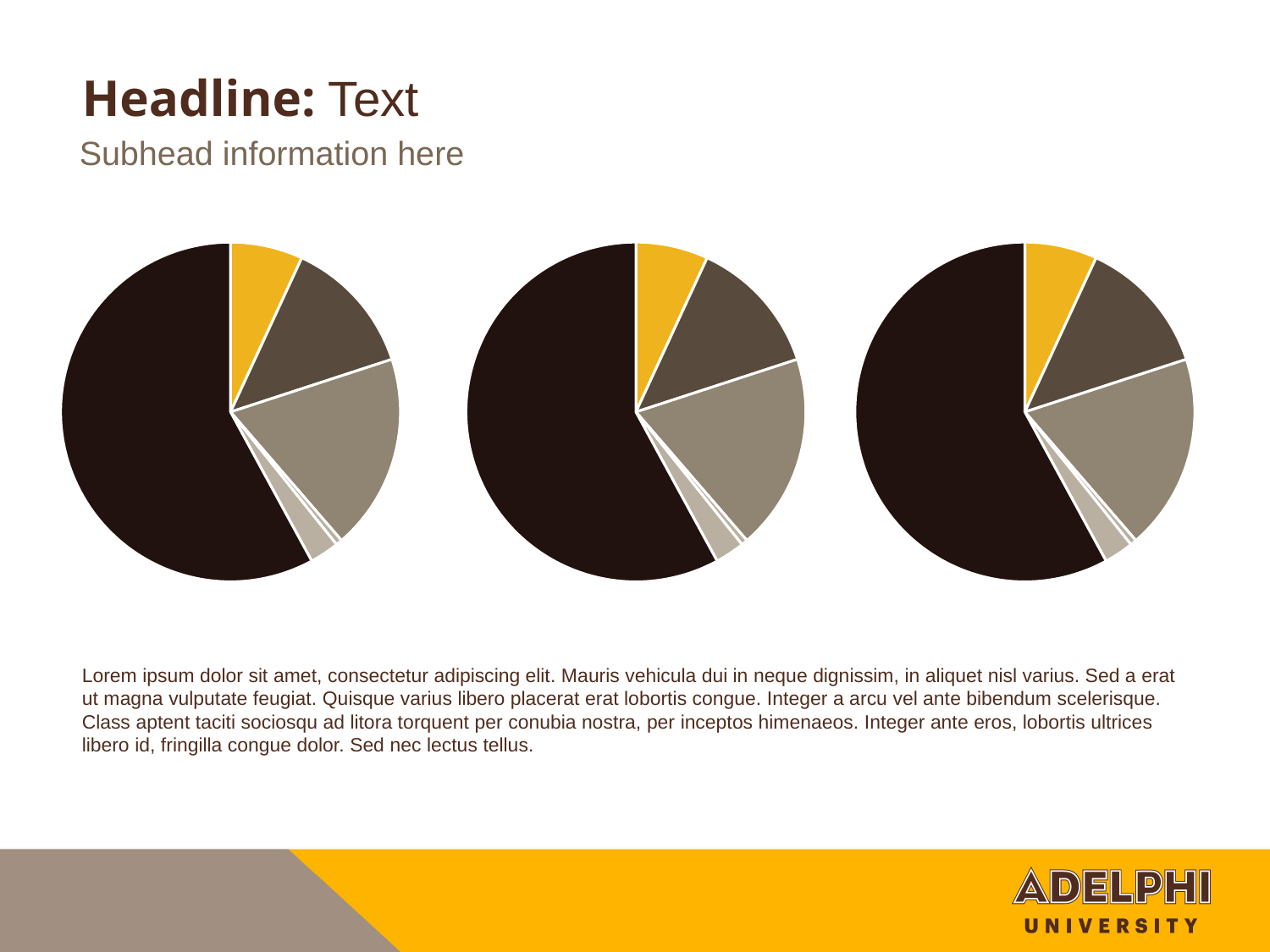
In the left pie chart, which colour slice is the largest? dark brown How many pie charts are on the slide? 3 Do the pie charts on the slide have a legend? No In the right pie chart, which colour slice is the largest? dark brown In the middle pie chart, which colour slice is the largest? dark brown In the right pie chart, which is larger, the yellow slice or the grey slice? grey What kind of chart is shown on the left of the slide? pie chart Do the pie charts on the slide show data labels? No In the left pie chart, which is larger, the yellow slice or the dark brown slice? dark brown In the middle pie chart, which is larger, the yellow slice or the dark taupe slice next to it? dark taupe